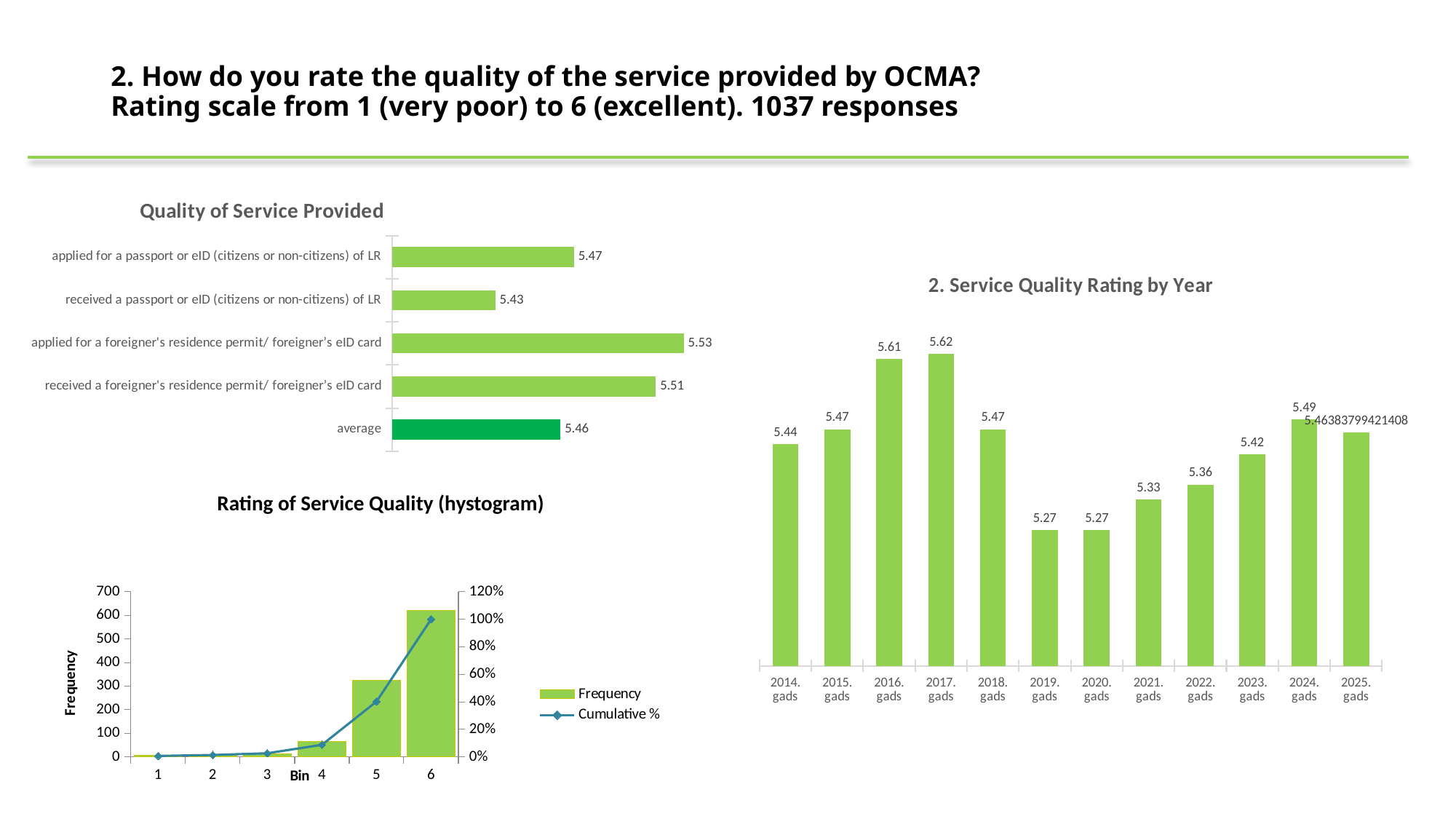
In the 'Quality of Service Provided' chart, what is the value for 'applied for a foreigner's residence permit/ foreigner's eID card'? 5.53 In the '2. Service Quality Rating by Year' chart, what is the rating for 2016. gads? 5.61 In the 'Rating of Service Quality (hystogram)' chart, which bin has the highest Frequency? 6 In the 'Quality of Service Provided' chart, which category has the lowest value? received a passport or eID (citizens or non-citizens) of LR In the 'Rating of Service Quality (hystogram)' chart, is the Frequency for bin 5 greater or less than 300? greater In the 'Quality of Service Provided' chart, what is the difference between the highest value (5.53) and the lowest value (5.43)? 0.10 In the 'Quality of Service Provided' chart, how many categories are plotted? 5 In the '2. Service Quality Rating by Year' chart, which year has the highest rating? 2017. gads In the '2. Service Quality Rating by Year' chart, what is the difference between the ratings for 2017. gads (5.62) and 2019. gads (5.27)? 0.35 In the 'Rating of Service Quality (hystogram)' chart, how many series does the legend list? 2 In the '2. Service Quality Rating by Year' chart, which is larger: the rating for 2022. gads or 2023. gads? 2023. gads In the 'Quality of Service Provided' chart, what is the value for 'average'? 5.46